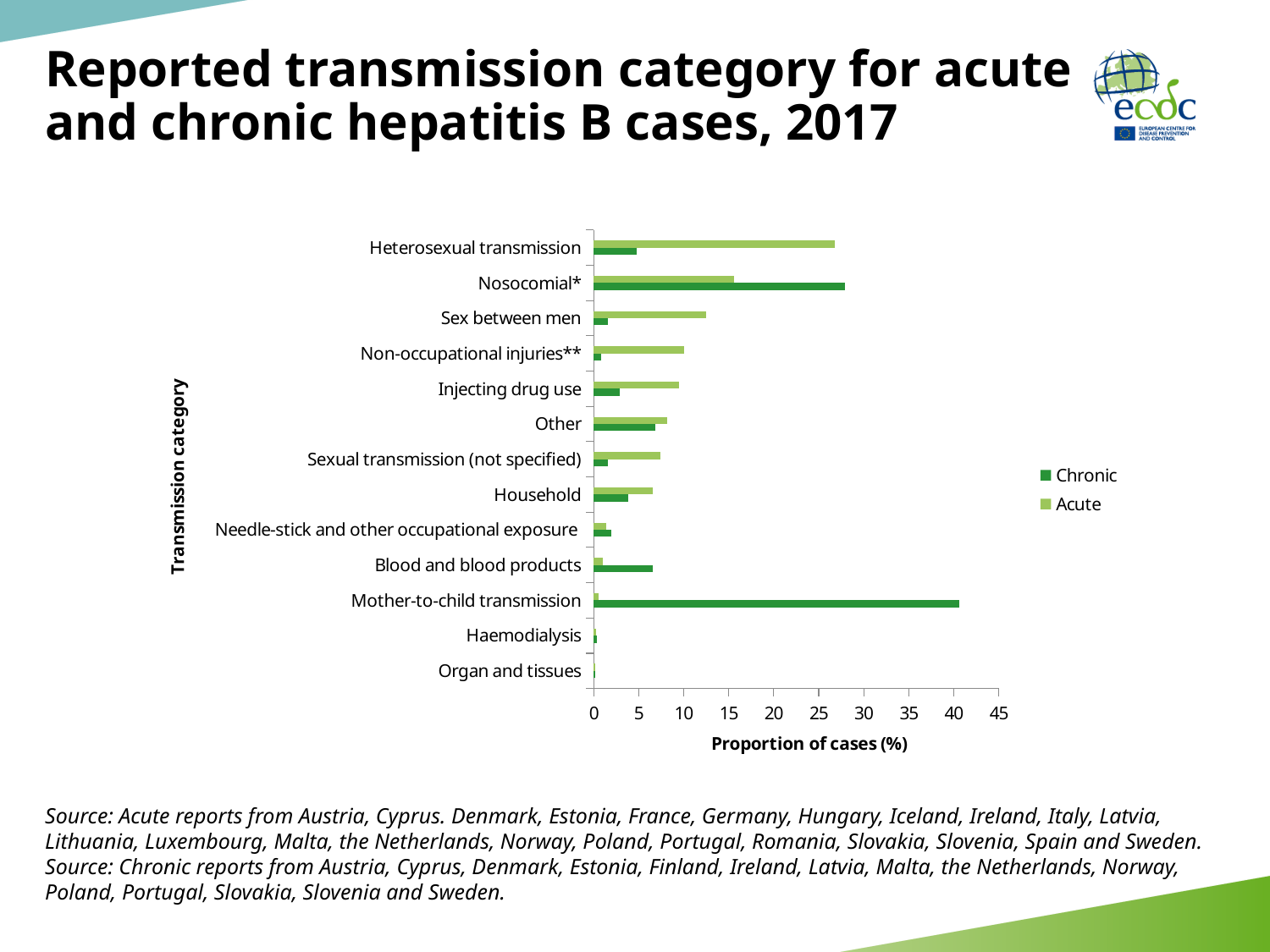
Which transmission category has the highest proportion of acute cases? Heterosexual transmission What kind of chart is shown on the slide? bar chart How many series does the legend list? 2 Which transmission category has the highest proportion of chronic cases? Mother-to-child transmission For Heterosexual transmission, which is larger: the chronic or the acute proportion? Acute Is the chronic value for Injecting drug use greater or less than 5? less Is the chronic value for Mother-to-child transmission greater or less than 35? greater For Nosocomial*, which is larger: the chronic or the acute proportion? Chronic How many transmission categories are shown on the chart? 13 Is the acute value for Heterosexual transmission greater or less than 25? greater What is the label of the x axis? Proportion of cases (%)